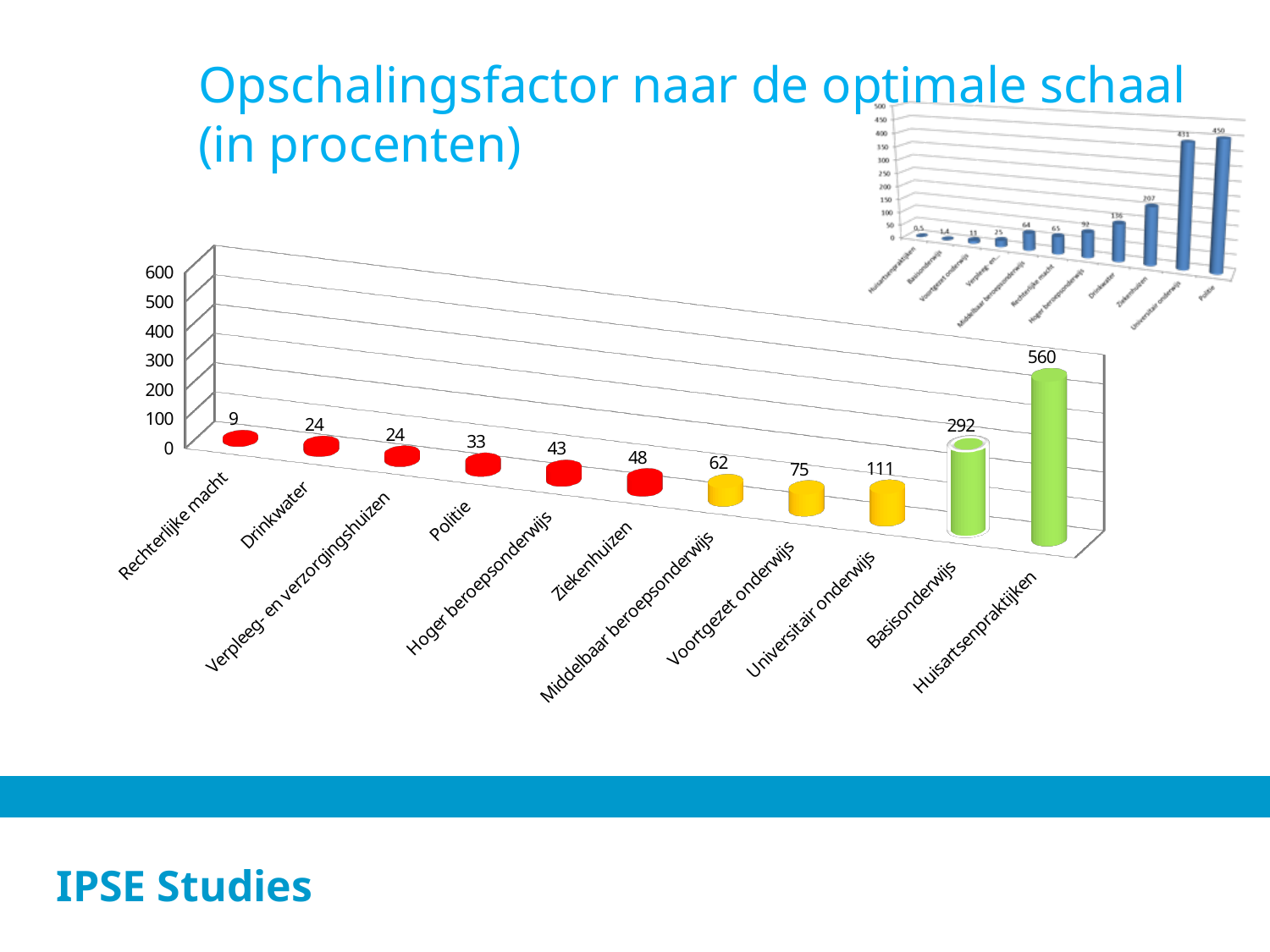
In the large chart, which category has the highest value? Huisartsenpraktijken What kind of chart is the large chart on the slide? Bar chart In the large chart, what is the difference between the values for Huisartsenpraktijken and Basisonderwijs? 268 In the large chart, what is the value for Politie? 33 In the large chart, which is larger: the value for Ziekenhuizen or the value for Middelbaar beroepsonderwijs? Middelbaar beroepsonderwijs In the large chart, what is the value for Huisartsenpraktijken? 560 In the large chart, what is the value for Universitair onderwijs? 111 In the large chart, what is the value for Basisonderwijs? 292 In the large chart, how many categories are plotted? 11 In the large chart, which category has the lowest value? Rechterlijke macht In the large chart, do the values rise or fall from left to right along the x axis? Rise What is the title of the large chart on the slide? Opschalingsfactor naar de optimale schaal (in procenten)